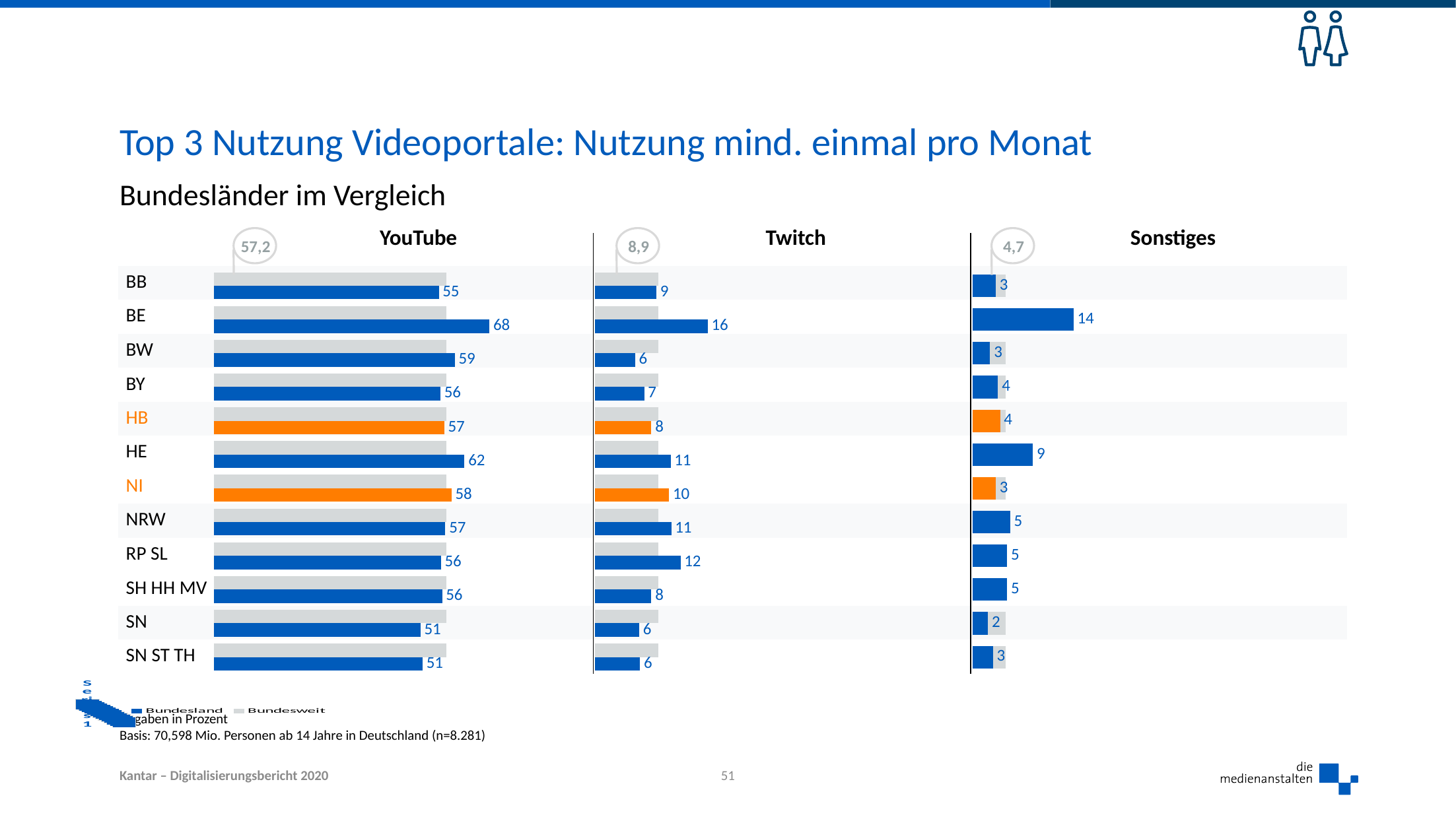
How many series does the legend list? 2 In the Sonstiges chart, which Bundesland has the lowest value? SN What kind of chart is the Twitch chart? bar chart In the YouTube chart, what is the value for BE? 68 In the YouTube chart, which Bundesland has the highest value? BE In the Sonstiges chart, what is the value for HE? 9 In the Twitch chart, what is the difference between the values for BE and BW? 10 In the YouTube chart, which is larger, the value for HE or the value for NRW? HE How many Bundesländer (categories) are shown in the YouTube chart? 12 In the Twitch chart, what is the value for RP SL? 12 In the Sonstiges chart, what is the value for SN ST TH? 3 What is the nationwide (Bundesweit) value shown in the circle above the Twitch chart? 8,9